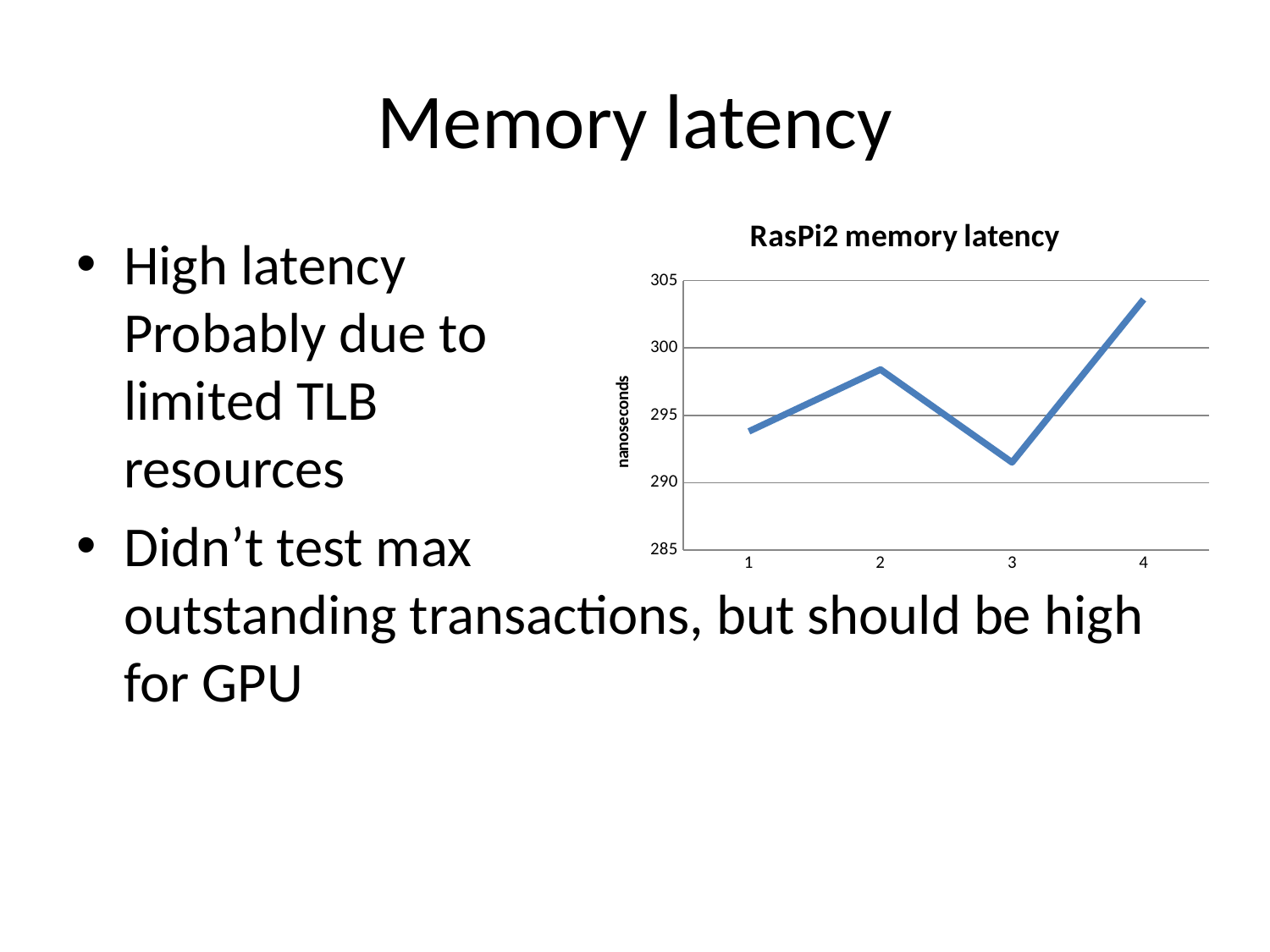
Which x-axis point has the lowest memory latency? 3 What is the label on the vertical axis of the chart? nanoseconds Is the value at point 1 greater or less than 295? less Is the value at point 2 greater or less than 295? greater Is the value at point 3 greater or less than 295? less What is the title of the chart? RasPi2 memory latency Does the value rise or fall from point 2 to point 3? fall Which x-axis point has the highest memory latency? 4 What kind of chart is shown on the slide? line chart How many data points are plotted on the line? 4 Which has the higher latency, point 2 or point 1? 2